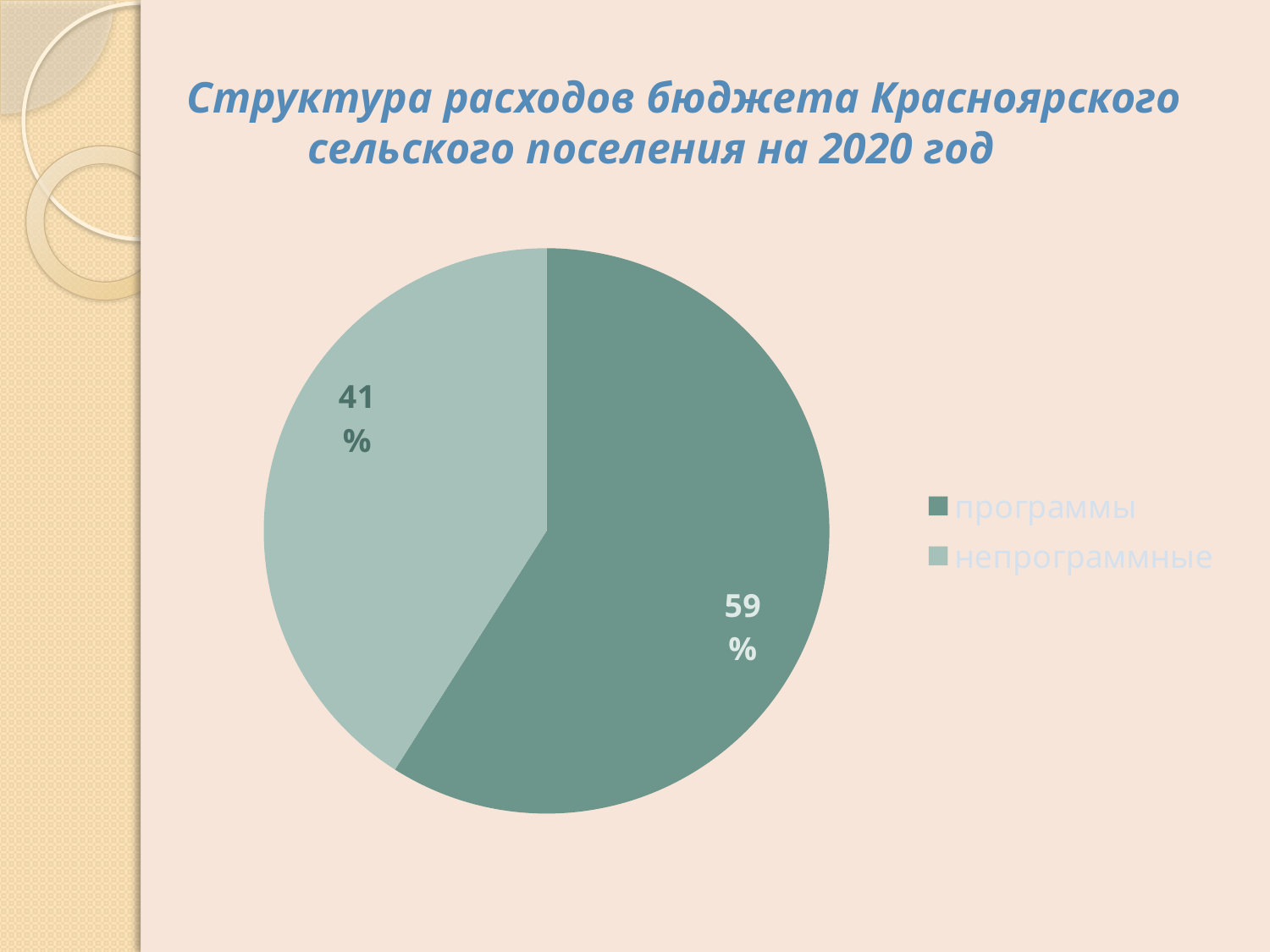
Which slice is the smallest in the pie chart? непрограммные How many entries does the legend list? 2 What share of the pie does the "непрограммные" slice represent? 41% How many slices does the pie chart have? 2 What kind of chart is shown on the slide? pie chart Which is larger, the "программы" slice or the "непрограммные" slice? программы What is the title of the slide containing the chart? Структура расходов бюджета Красноярского сельского поселения на 2020 год What is the difference in percentage points between the "программы" and "непрограммные" slices? 18 Which legend entry is shown in the darker green colour? программы Which slice is the largest in the pie chart? программы What share of the pie does the "программы" slice represent? 59%